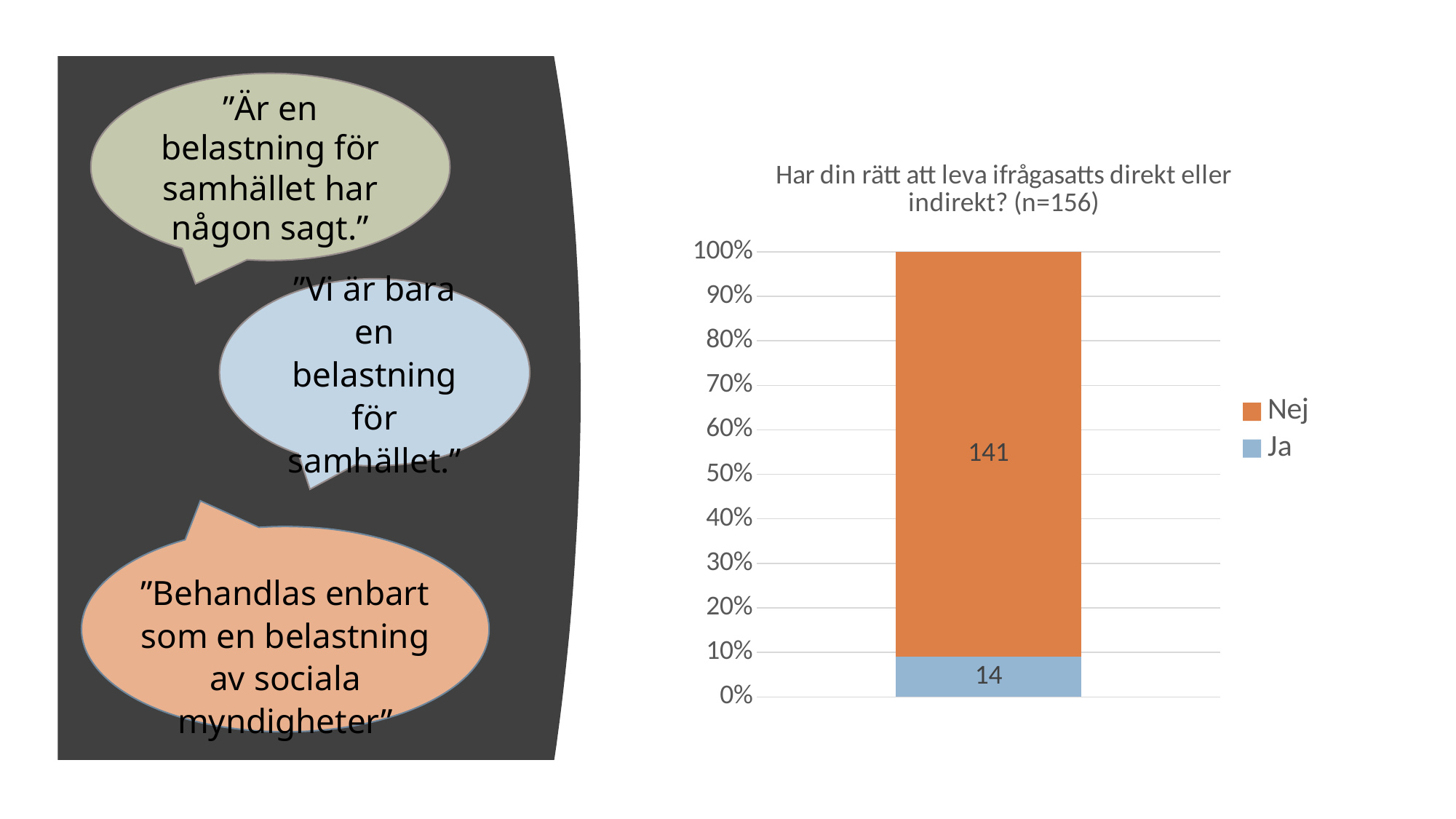
What value is shown for the Nej series in the chart? 141 What is the title of the chart? Har din rätt att leva ifrågasatts direkt eller indirekt? (n=156) How many series does the legend list? 2 What kind of chart is shown on the slide? Stacked bar chart What is the total of the two data labels in the stacked bar? 155 Is the share of the bar taken by Ja greater or less than 10%? less What value is shown for the Ja series in the chart? 14 Which series has the largest value in the chart? Nej Which series has the smallest value in the chart? Ja Is the share of the bar taken by Nej greater or less than 90%? greater What is the difference between the Nej value and the Ja value? 127 Which series has the larger value, Nej or Ja? Nej